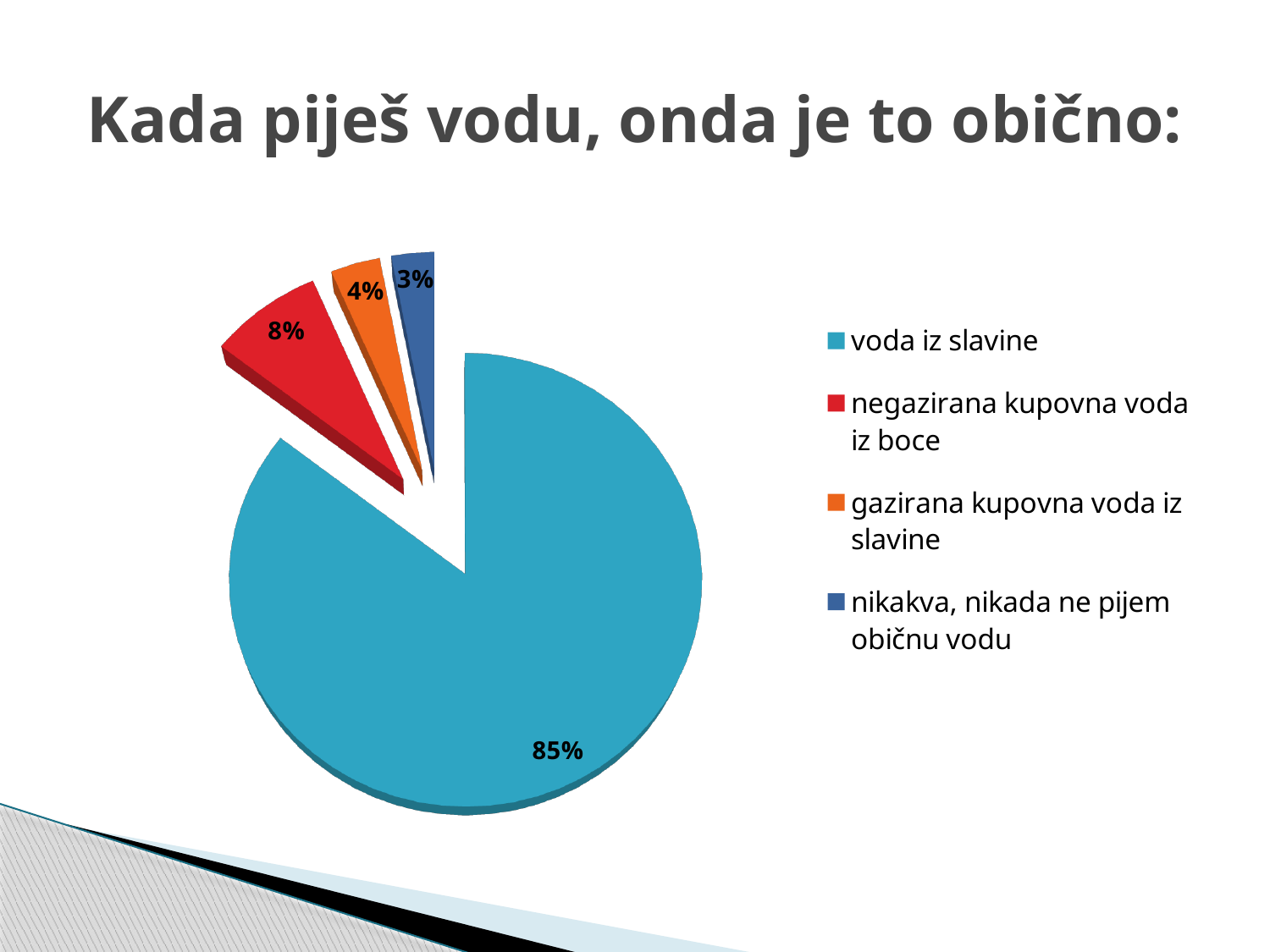
What is the value for "nikakva, nikada ne pijem običnu vodu"? 3% How many categories does the pie chart show? 4 Which category has the smallest slice of the pie? nikakva, nikada ne pijem običnu vodu What share of the pie does "voda iz slavine" have? 85% What is the difference between the values for "gazirana kupovna voda iz slavine" and "nikakva, nikada ne pijem običnu vodu"? 1% What is the difference between the values for "voda iz slavine" and "negazirana kupovna voda iz boce"? 77% What kind of chart is shown on the slide? pie chart Which is larger, the value for "negazirana kupovna voda iz boce" or the value for "gazirana kupovna voda iz slavine"? negazirana kupovna voda iz boce What is the value for "gazirana kupovna voda iz slavine"? 4% Which category has the largest slice of the pie? voda iz slavine What is the title of the slide above the chart? Kada piješ vodu, onda je to obično: What is the value for "negazirana kupovna voda iz boce"? 8%